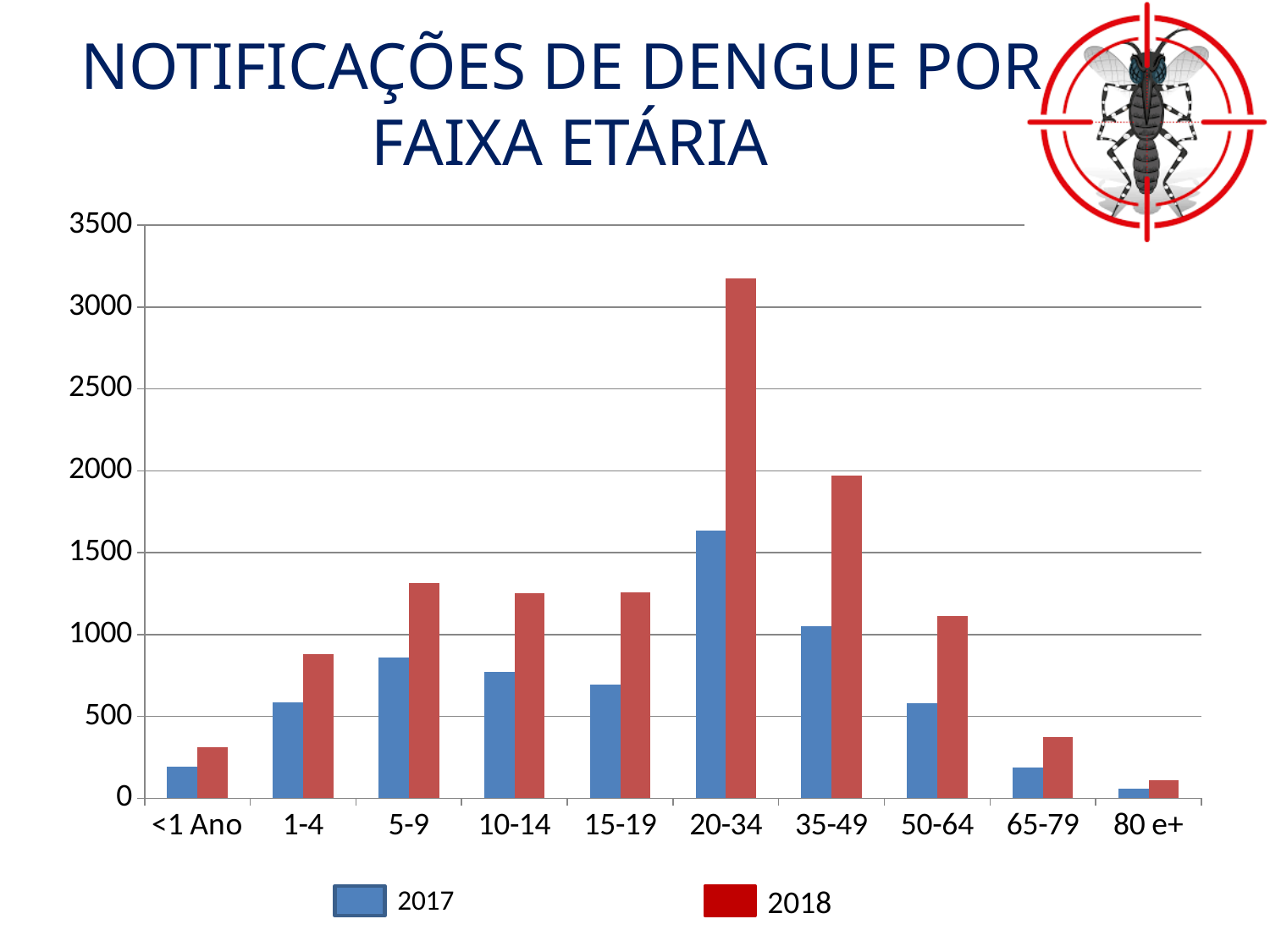
For the 35-49 age group, which year has the larger value, 2017 or 2018? 2018 Which age group has the highest value for 2018? 20-34 Which age group has the lowest value for 2018? 80 e+ What are the two entries in the legend? 2017 and 2018 Is the 2017 value for 5-9 greater or less than 1000? less For 2018, which age group has the larger value, 35-49 or 50-64? 35-49 Is the 2018 value for 20-34 greater or less than 3000? greater How many age-group categories are shown on the x axis? 10 What kind of chart is shown on the slide? bar chart Is the 2017 value for 35-49 greater or less than 1000? greater How many series does the legend list? 2 Which age group has the highest value for 2017? 20-34